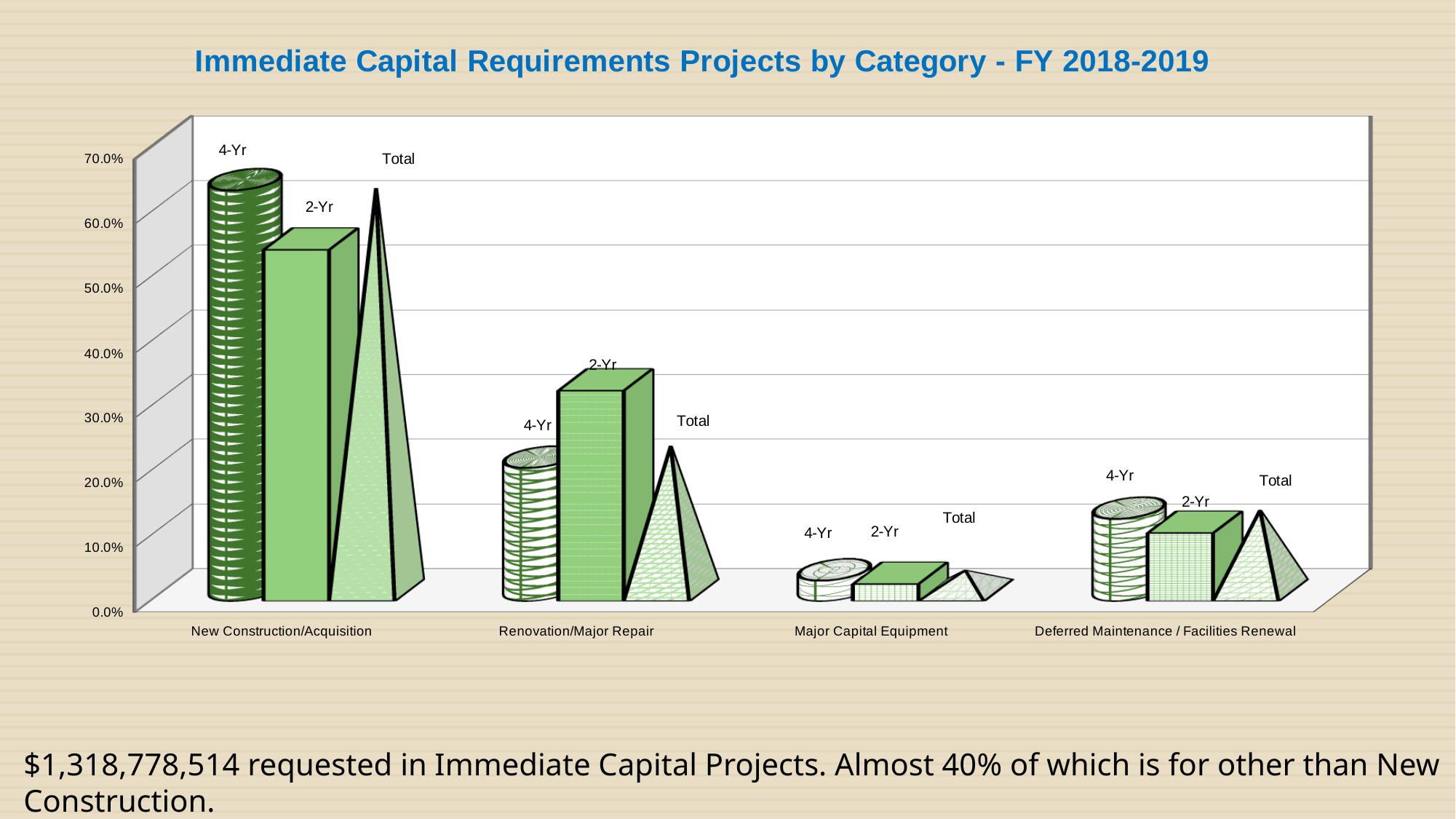
Is the Total value for Major Capital Equipment greater or less than 10.0%? less Is the 2-Yr value for Renovation/Major Repair greater or less than 40.0%? less What kind of chart is shown on the slide? bar chart Is the 4-Yr value for New Construction/Acquisition greater or less than 60.0%? greater For New Construction/Acquisition, which is larger, the 4-Yr value or the 2-Yr value? 4-Yr What is the title of the chart? Immediate Capital Requirements Projects by Category - FY 2018-2019 How many categories are shown on the x axis of the chart? 4 For Renovation/Major Repair, which is larger, the 4-Yr value or the 2-Yr value? 2-Yr How many data series are labelled in the chart? 3 Which category has the highest 4-Yr value? New Construction/Acquisition Which category has the lowest 2-Yr value? Major Capital Equipment